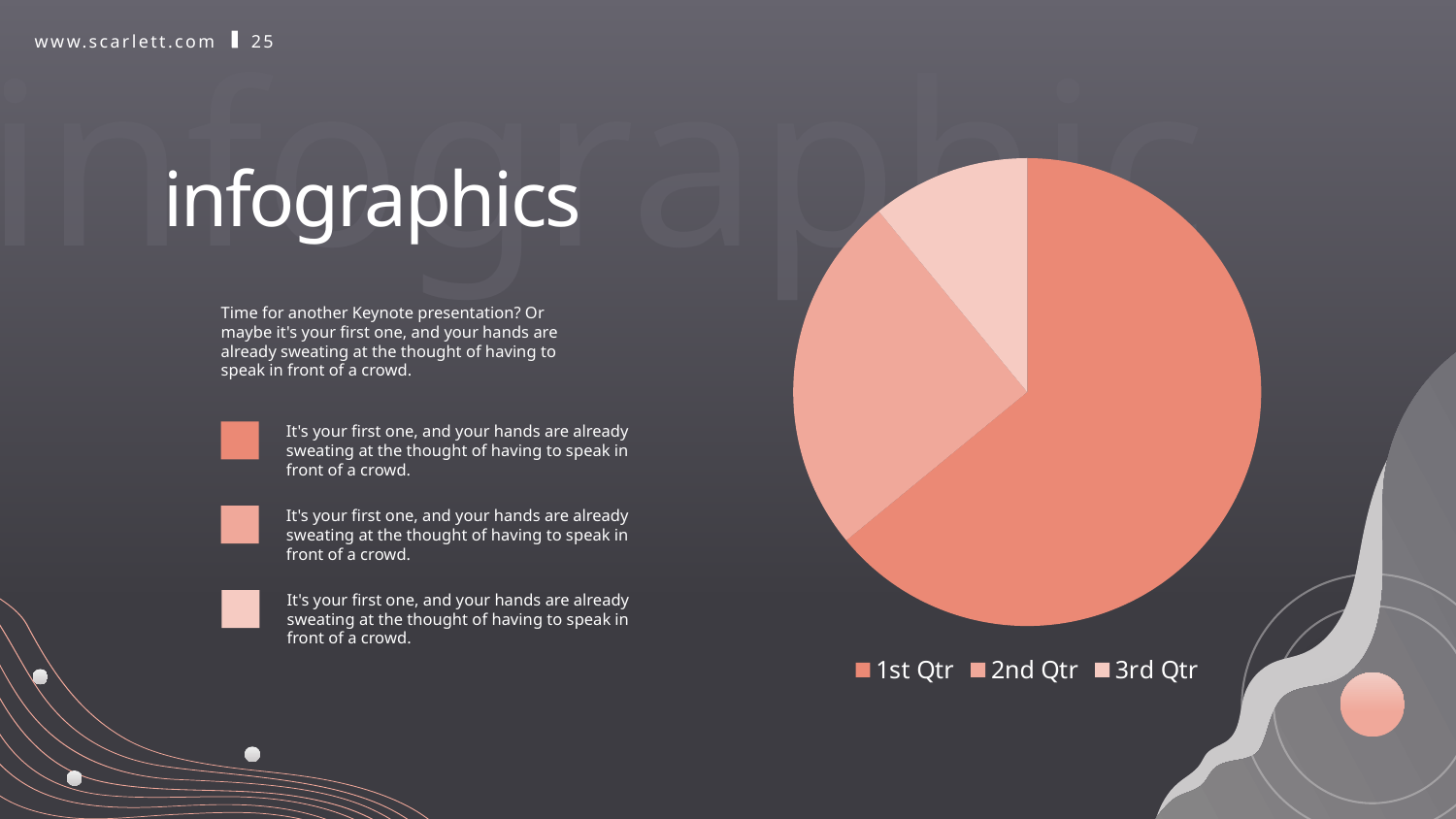
What kind of chart is shown on the slide? pie chart Does the 1st Qtr slice take up more or less than half of the pie chart? more Where is the legend positioned relative to the pie chart? below the chart Which category has the smallest slice in the pie chart? 3rd Qtr What are the legend entries of the pie chart, in order? 1st Qtr, 2nd Qtr, 3rd Qtr Which slice is smaller in the pie chart, 1st Qtr or 3rd Qtr? 3rd Qtr Which category has the largest slice in the pie chart? 1st Qtr Which slice is larger in the pie chart, 1st Qtr or 2nd Qtr? 1st Qtr How many entries does the legend of the pie chart list? 3 How many slices does the pie chart have? 3